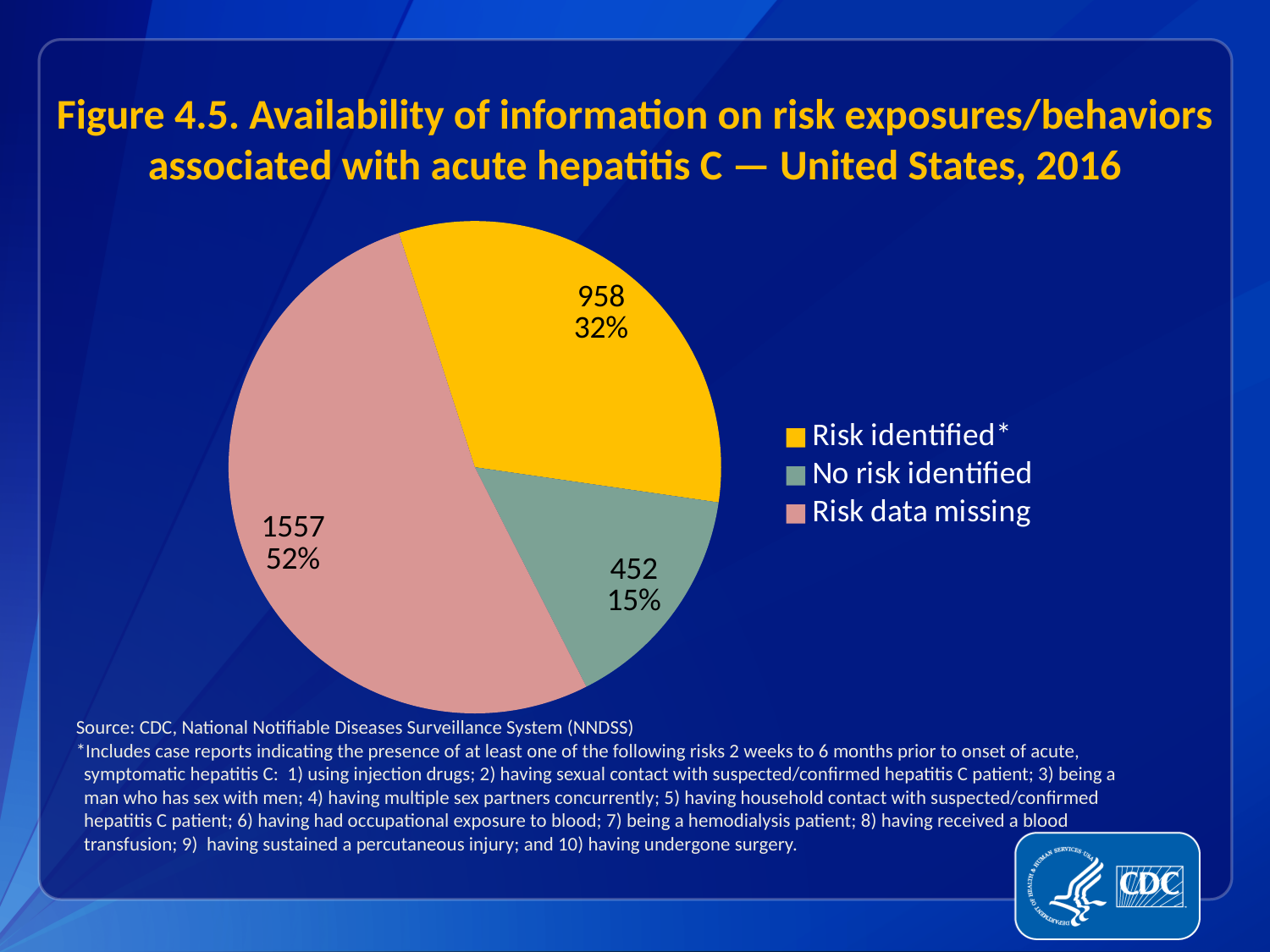
How many cases are in the 'Risk data missing' slice? 1557 What colour is the 'Risk data missing' slice? pink What share of the pie does 'Risk identified*' represent? 32% What percentage of cases had no risk identified? 15% What is the difference in the number of cases between 'Risk data missing' and 'Risk identified*'? 599 What is the total number of cases across all three slices? 2967 Which category has the smallest slice of the pie? No risk identified How many cases are in the 'Risk identified*' slice? 958 How many categories does the pie chart have? 3 Which category has the largest slice of the pie? Risk data missing Which is larger, the number of cases with risk identified or the number with no risk identified? Risk identified* What kind of chart is shown on the slide? pie chart